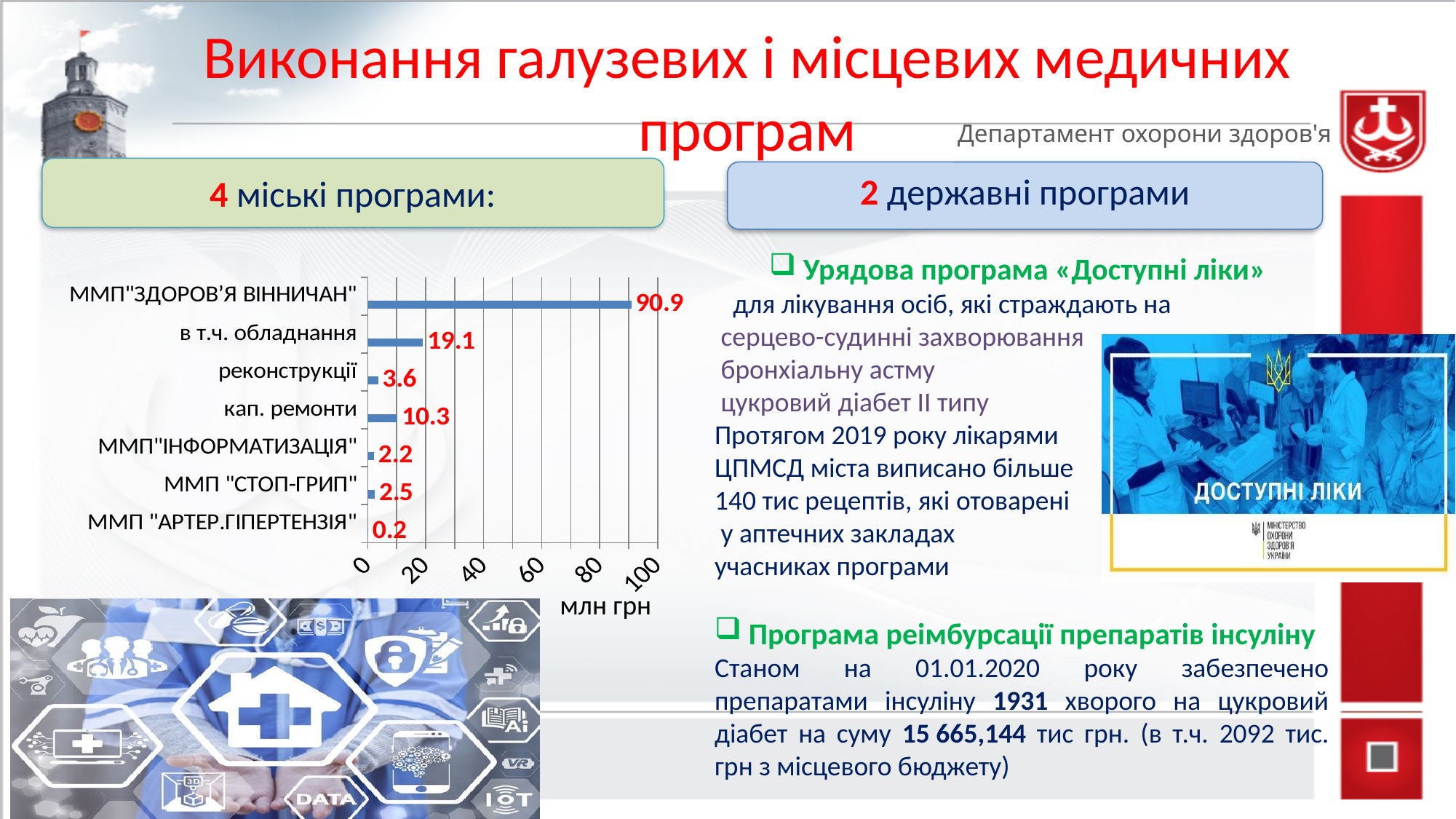
How many categories are shown in the bar chart? 7 What is the difference between the values for в т.ч. обладнання and кап. ремонти? 8.8 What is the value for в т.ч. обладнання in the bar chart? 19.1 What type of chart is shown on the slide? bar chart What unit is shown on the horizontal axis of the bar chart? млн грн What is the value for ММП"ЗДОРОВ'Я ВІННИЧАН" in the bar chart? 90.9 Which is larger in the bar chart: реконструкції or ММП"ІНФОРМАТИЗАЦІЯ"? реконструкції What is the value for ММП "СТОП-ГРИП" in the bar chart? 2.5 Which category has the lowest value in the bar chart? ММП "АРТЕР.ГІПЕРТЕНЗІЯ" Is the value for ММП"ЗДОРОВ'Я ВІННИЧАН" greater or less than 80? greater What is the value for кап. ремонти in the bar chart? 10.3 Which category has the highest value in the bar chart? ММП"ЗДОРОВ'Я ВІННИЧАН"